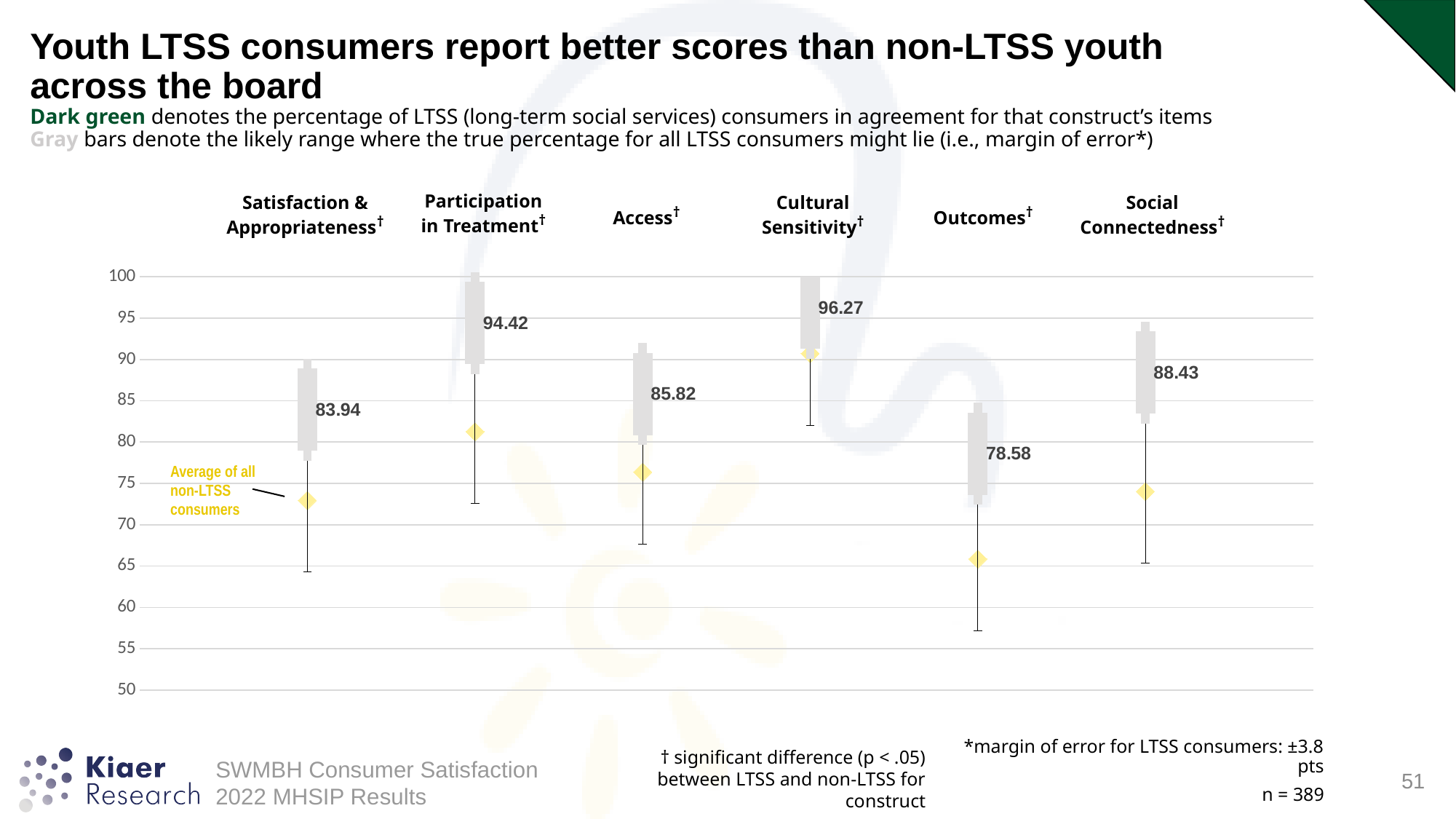
What is the difference between the LTSS scores for Cultural Sensitivity and Outcomes? 17.69 Is the average of all non-LTSS consumers for Satisfaction & Appropriateness greater or less than 75? less Which construct has the lowest LTSS consumer score? Outcomes Which construct has the highest LTSS consumer score? Cultural Sensitivity Is the average of all non-LTSS consumers for Outcomes greater or less than 70? less What is the LTSS consumer score for Outcomes? 78.58 What is the LTSS consumer score for Satisfaction & Appropriateness? 83.94 What is the LTSS consumer score for Cultural Sensitivity? 96.27 What is the LTSS consumer score for Participation in Treatment? 94.42 How many constructs are plotted on the chart? 6 Which has a higher LTSS score, Access or Social Connectedness? Social Connectedness What do the yellow diamonds on the chart represent? Average of all non-LTSS consumers